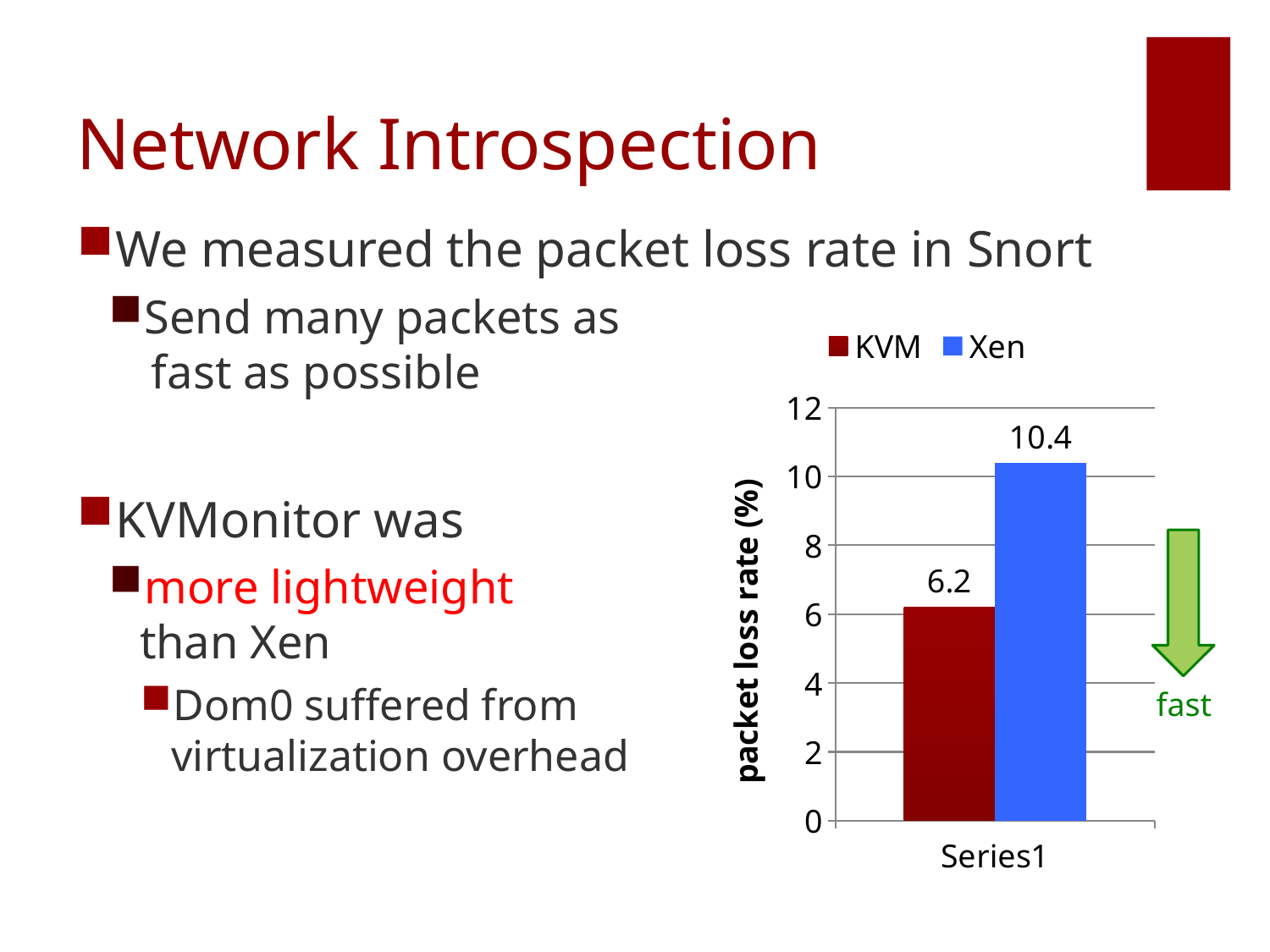
What is the maximum value shown on the y axis? 12 How many series does the legend list? 2 Which series has the lower packet loss rate? KVM What is the packet loss rate for KVM? 6.2 Which series has the higher packet loss rate, KVM or Xen? Xen What is the category label shown on the x axis? Series1 Is the packet loss rate for KVM greater or less than 8? less Is the packet loss rate for Xen greater or less than 10? greater What is the label of the y axis? packet loss rate (%) What kind of chart is shown on the slide? bar chart What is the difference between the packet loss rates of Xen and KVM? 4.2 What is the packet loss rate for Xen? 10.4